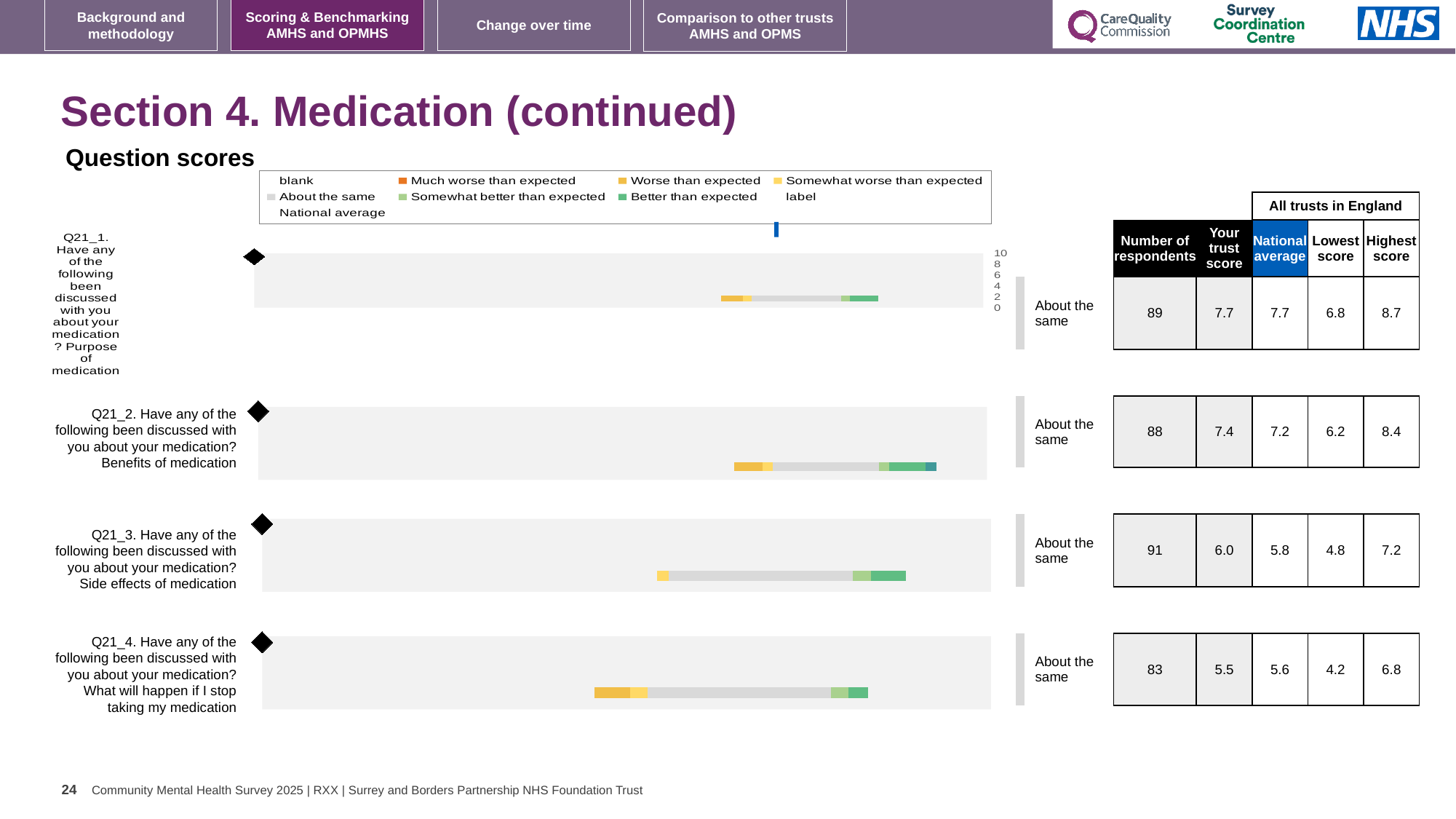
What is the 'Your trust score' value for Q21_1 (Purpose of medication)? 7.7 What is the lowest score among all trusts in England for Q21_3 (Side effects of medication)? 4.8 What is the national average for Q21_4 (What will happen if I stop taking my medication)? 5.6 What is the difference between the trust score and the national average for Q21_2 (Benefits of medication)? 0.2 What is the highest score among all trusts in England for Q21_2 (Benefits of medication)? 8.4 For Q21_4, which is larger: the trust score or the national average? National average Which question has the lowest 'Your trust score'? Q21_4 (What will happen if I stop taking my medication) What is the number of respondents for Q21_3 (Side effects of medication)? 91 Which question has the highest 'Your trust score'? Q21_1 (Purpose of medication) How many questions (bars) are plotted in the Question scores chart? 4 What benchmark label is shown next to each of the four question bars? About the same What kind of chart is used to show the question scores on this slide? bar chart